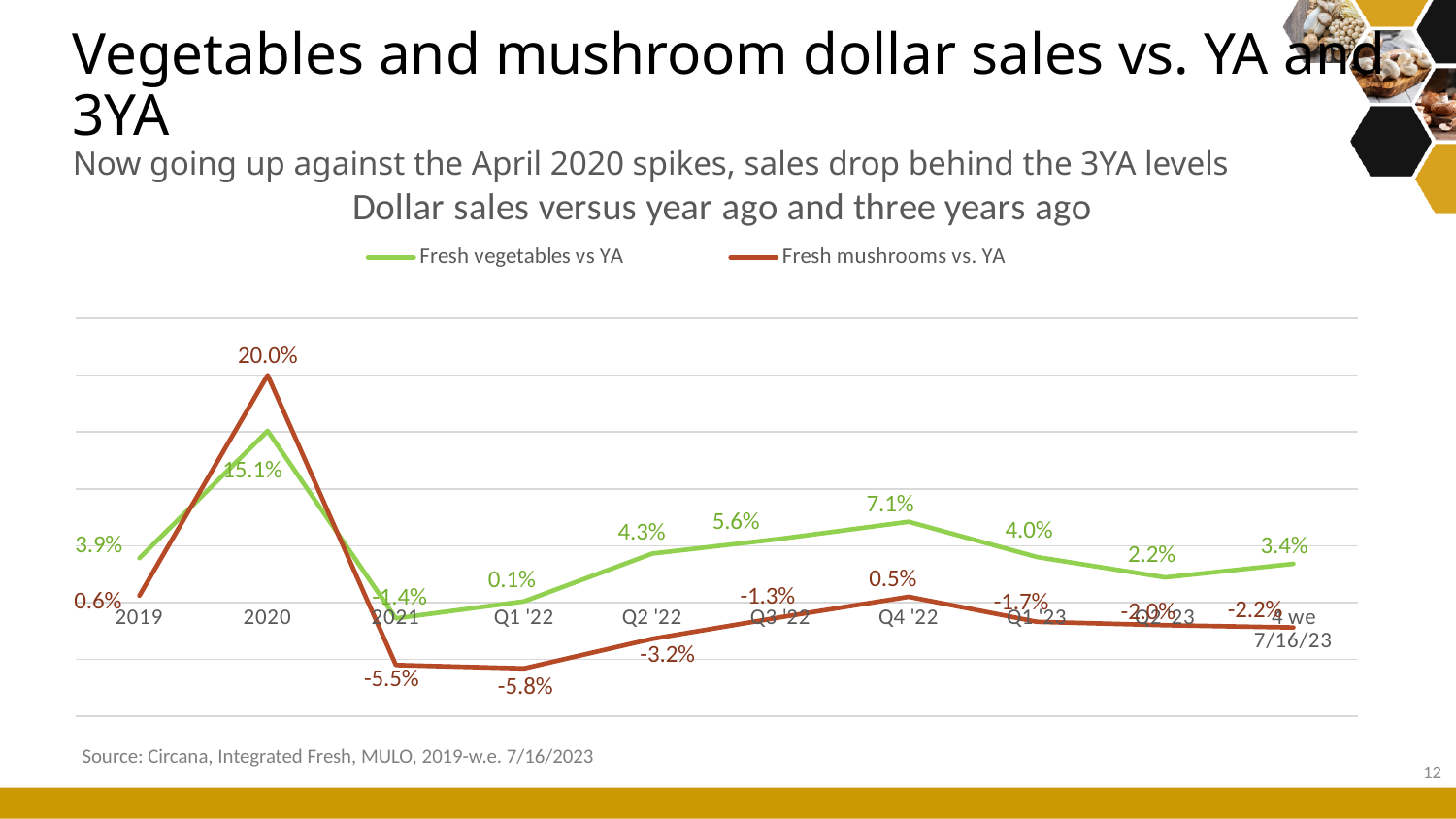
In which period is the Fresh vegetables vs YA value highest? 2020 In Q2 '22, which series has the larger value, Fresh vegetables vs YA or Fresh mushrooms vs. YA? Fresh vegetables vs YA What is the title of the chart? Dollar sales versus year ago and three years ago How many time periods are plotted along the x axis? 10 In 2020, how much higher is the Fresh mushrooms vs. YA value than the Fresh vegetables vs YA value? 4.9 percentage points What kind of chart is shown on the slide? Line chart What is the value for Fresh mushrooms vs. YA in 2020? 20.0% In which period is the Fresh mushrooms vs. YA value lowest? Q1 '22 Does the Fresh vegetables vs YA line rise or fall from Q1 '22 to Q4 '22? Rise What is the value for Fresh vegetables vs YA in Q4 '22? 7.1% How many series does the legend list? 2 What is the value for Fresh mushrooms vs. YA in Q1 '22? -5.8%